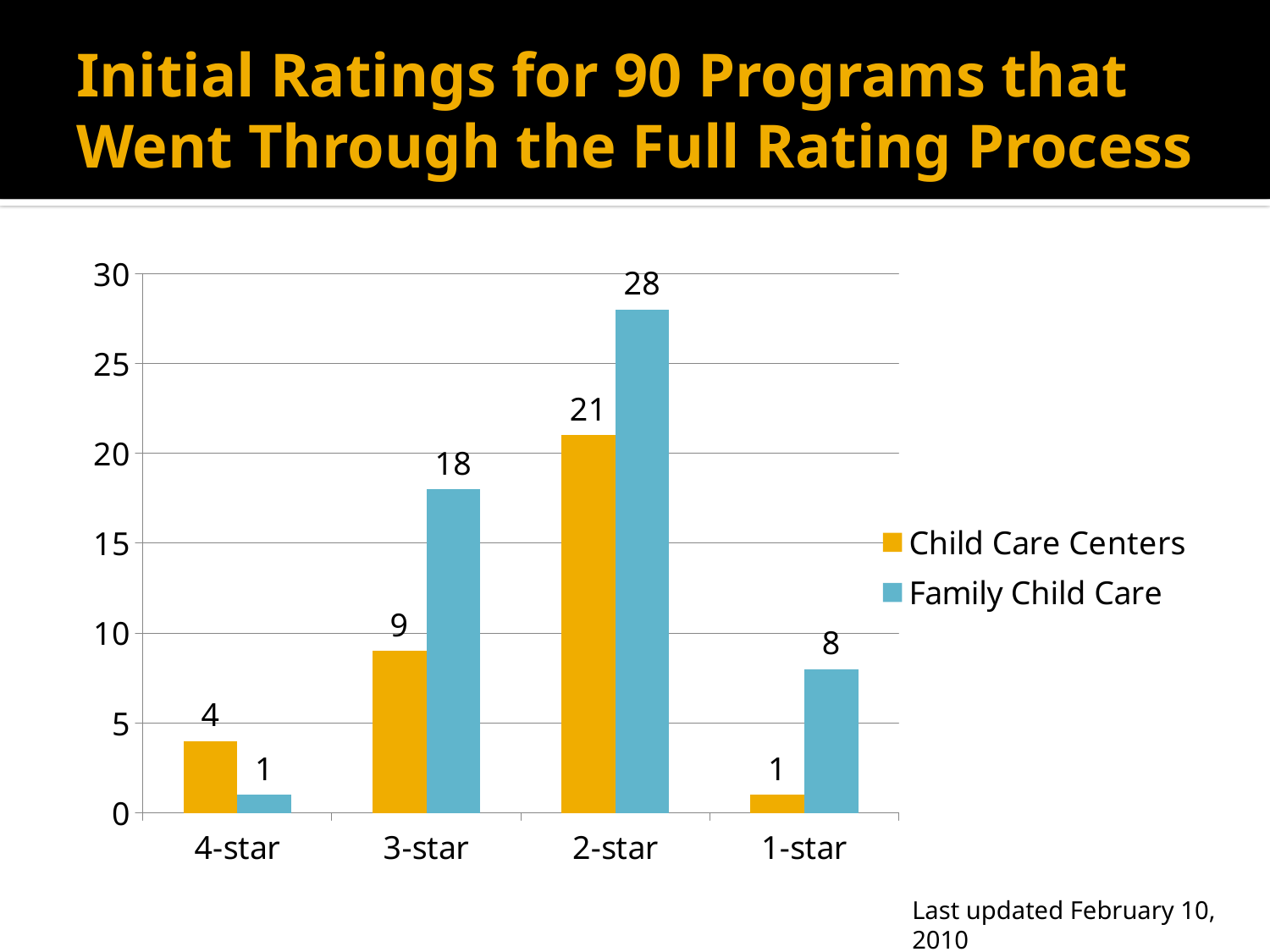
Which is larger at 4-star: Child Care Centers or Family Child Care? Child Care Centers What is the difference between Family Child Care and Child Care Centers at 2-star? 7 What is the value for Family Child Care at 3-star? 18 Is the value for Family Child Care at 3-star greater or less than 15? greater What colour are the Family Child Care bars? blue What is the value for Child Care Centers at 2-star? 21 Which rating category has the lowest value for Child Care Centers? 1-star Which rating category has the highest value for Family Child Care? 2-star What is the value for Family Child Care at 1-star? 8 How many series does the legend list? 2 How many rating categories are shown on the x axis? 4 What kind of chart is shown on the slide? bar chart